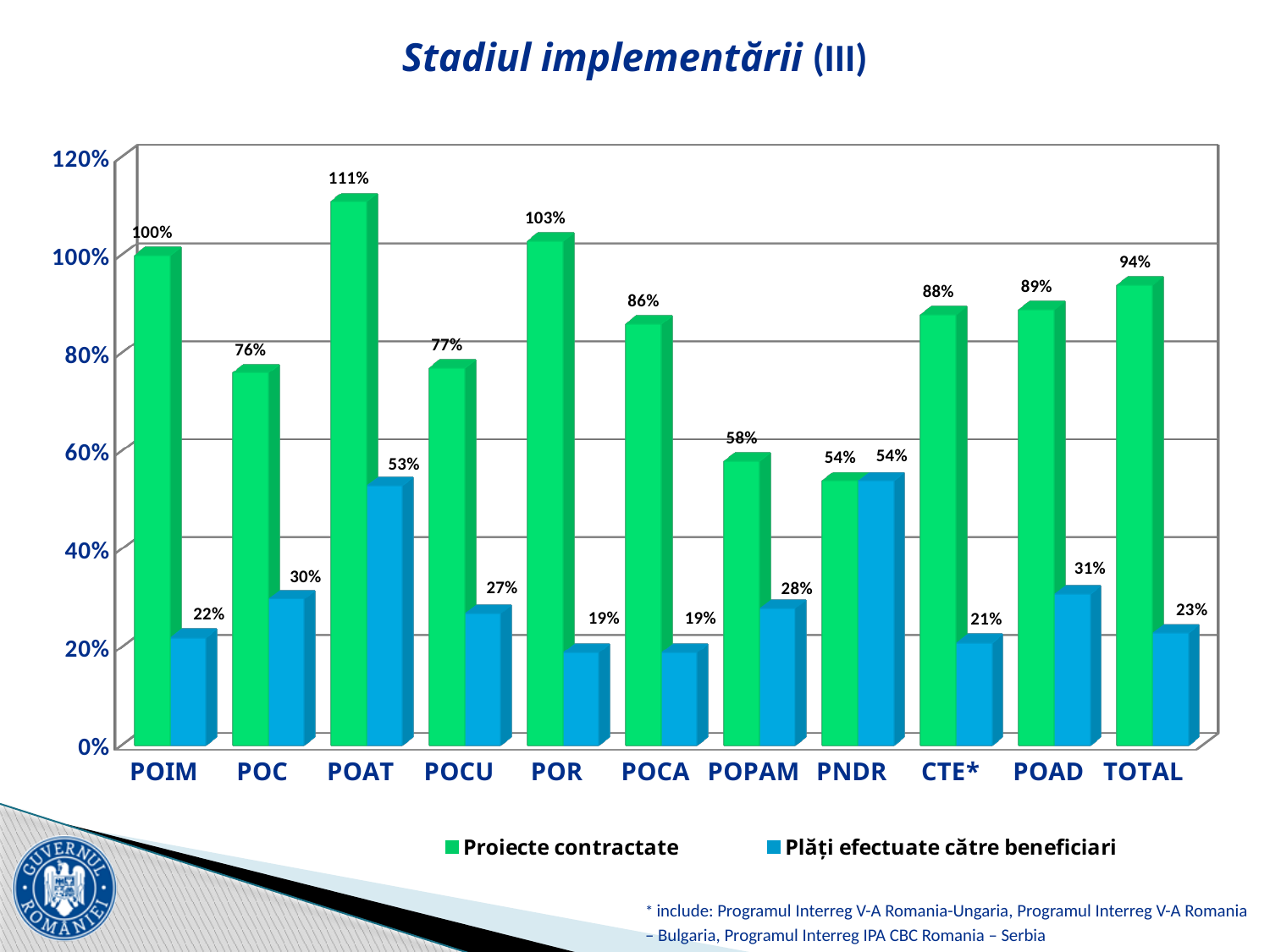
What colour are the bars for Plăți efectuate către beneficiari? Blue How many series does the legend list? 2 What kind of chart is shown on the slide? Bar chart Which is larger, Plăți efectuate către beneficiari for POAT or for POAD? POAT What is the difference between Proiecte contractate and Plăți efectuate către beneficiari for POIM? 78% Which category has the lowest value for Proiecte contractate? PNDR Which category has the highest value for Proiecte contractate? POAT How many categories are shown on the x axis? 11 Which category has the highest value for Plăți efectuate către beneficiari? PNDR What is the value of Proiecte contractate for POAT? 111% What is the value of Plăți efectuate către beneficiari for TOTAL? 23% What is the value of Plăți efectuate către beneficiari for PNDR? 54%